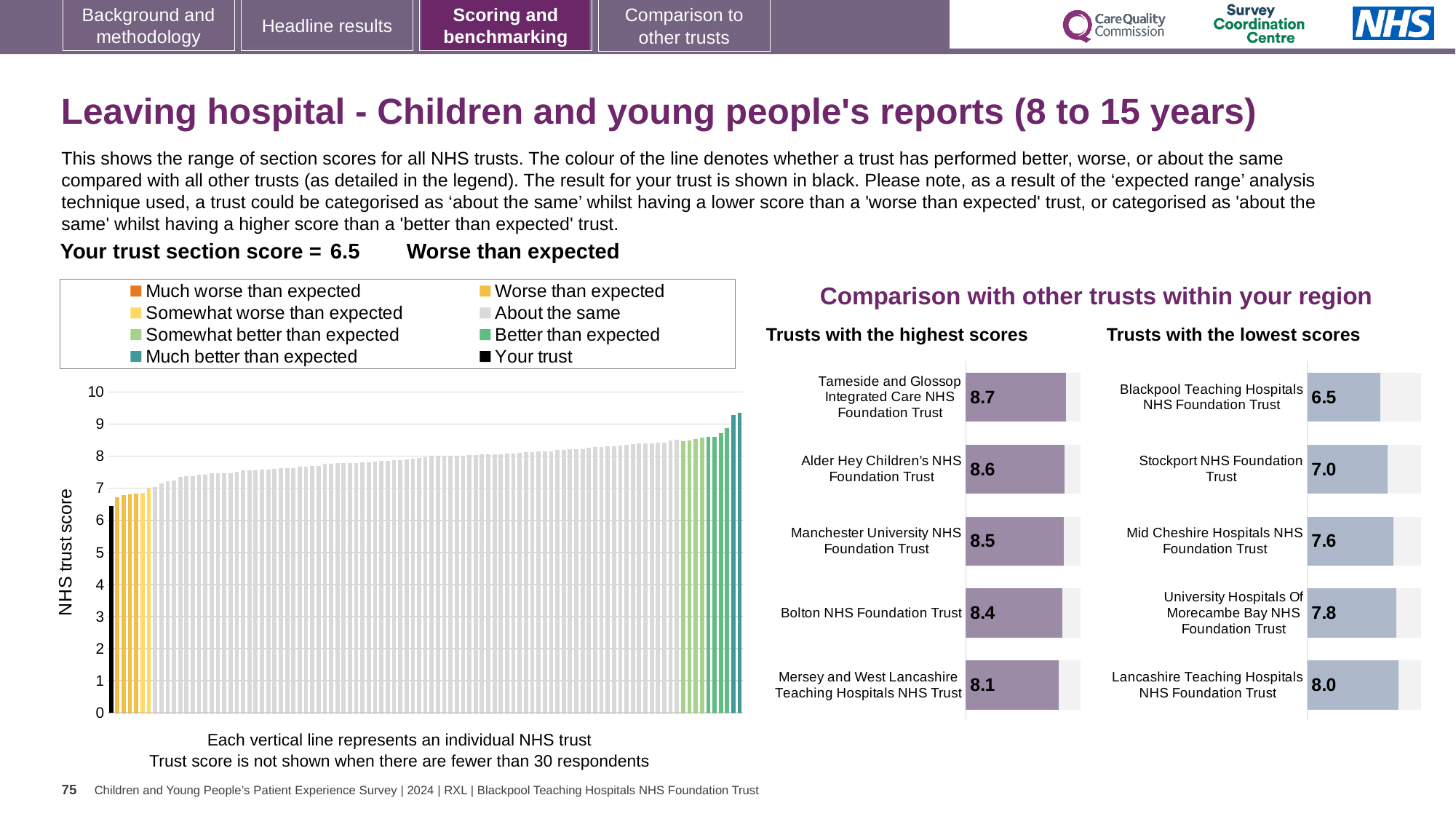
In the 'Trusts with the highest scores' chart, what is the score for Tameside and Glossop Integrated Care NHS Foundation Trust? 8.7 In the 'Trusts with the lowest scores' chart, what is the difference between the scores of Lancashire Teaching Hospitals NHS Foundation Trust and Blackpool Teaching Hospitals NHS Foundation Trust? 1.5 In the 'Trusts with the highest scores' chart, which has the higher score: Alder Hey Children's NHS Foundation Trust or Bolton NHS Foundation Trust? Alder Hey Children's NHS Foundation Trust How many trusts are shown in the 'Trusts with the highest scores' chart? 5 In the 'Trusts with the lowest scores' chart, what is the score for Stockport NHS Foundation Trust? 7.0 In the 'Trusts with the highest scores' chart, what is the difference between the scores of Tameside and Glossop Integrated Care NHS Foundation Trust and Mersey and West Lancashire Teaching Hospitals NHS Trust? 0.6 In the large 'NHS trust score' chart on the left, do the trust scores rise or fall from left to right? Rise In the 'Trusts with the highest scores' chart, which trust has the highest score? Tameside and Glossop Integrated Care NHS Foundation Trust In the 'Trusts with the lowest scores' chart, what is the score for Mid Cheshire Hospitals NHS Foundation Trust? 7.6 In the 'Trusts with the lowest scores' chart, which trust has the lowest score? Blackpool Teaching Hospitals NHS Foundation Trust How many entries does the legend above the large 'NHS trust score' chart list? 8 What kind of chart is the large 'NHS trust score' chart on the left of the slide? Bar chart